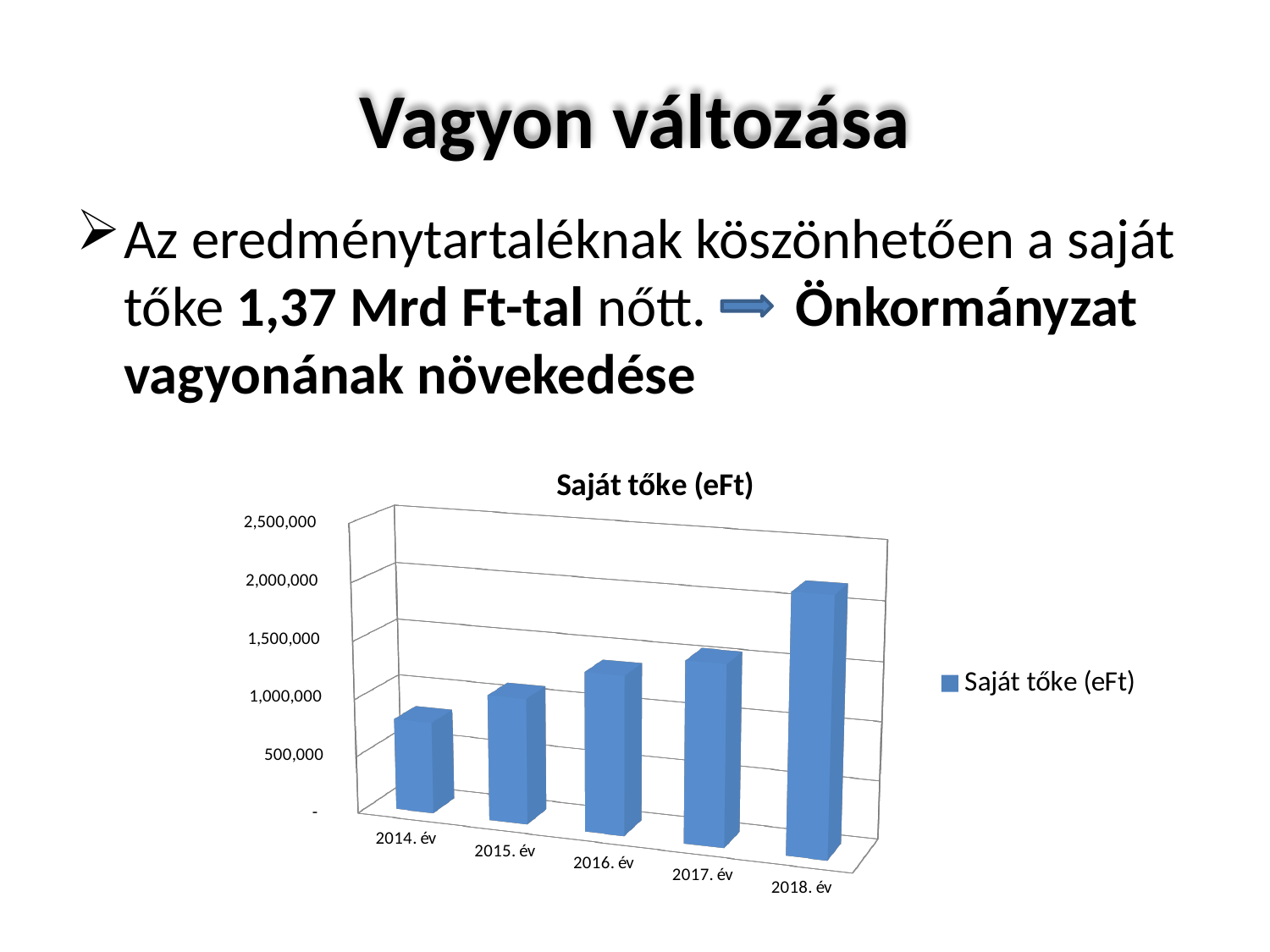
Do the Saját tőke values rise or fall from 2014 to 2018? rise How many years are shown on the x axis of the chart? 5 How many series does the chart legend list? 1 Which year has the highest Saját tőke value? 2018. év What is the highest value shown on the chart's vertical axis? 2,500,000 Is the Saját tőke value for 2017. év greater or less than 2,000,000? less Is the Saját tőke value for 2018. év greater or less than 1,500,000? greater Is the Saját tőke value for 2014. év greater or less than 1,000,000? less Which year has the lowest Saját tőke value? 2014. év What kind of chart is shown on the slide? bar chart Which is larger, the Saját tőke value for 2016. év or for 2018. év? 2018. év What is the title of the chart? Saját tőke (eFt)